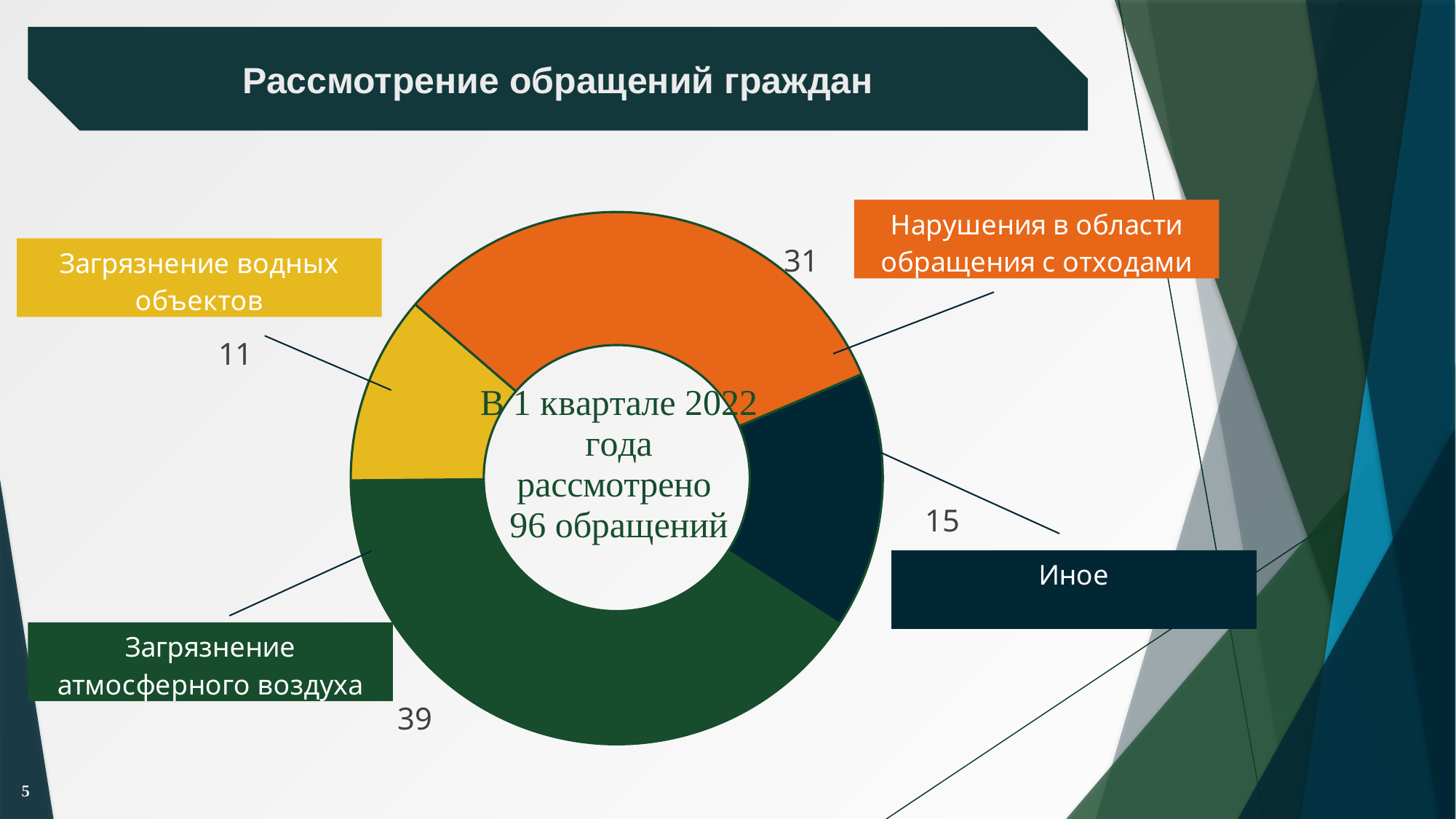
What is the value for Нарушения в области обращения с отходами? 31 Which is larger: the value for Иное or the value for Загрязнение водных объектов? Иное How many categories does the doughnut chart show? 4 What is the difference between the values for Загрязнение атмосферного воздуха and Нарушения в области обращения с отходами? 8 Which category has the lowest value? Загрязнение водных объектов What type of chart is shown on the slide? Doughnut chart What is the value for Загрязнение водных объектов? 11 What colour is the segment for Нарушения в области обращения с отходами? Orange What is the value for Иное? 15 What is the value for Загрязнение атмосферного воздуха? 39 Which category has the highest value? Загрязнение атмосферного воздуха What is the total of all segments in the doughnut chart? 96